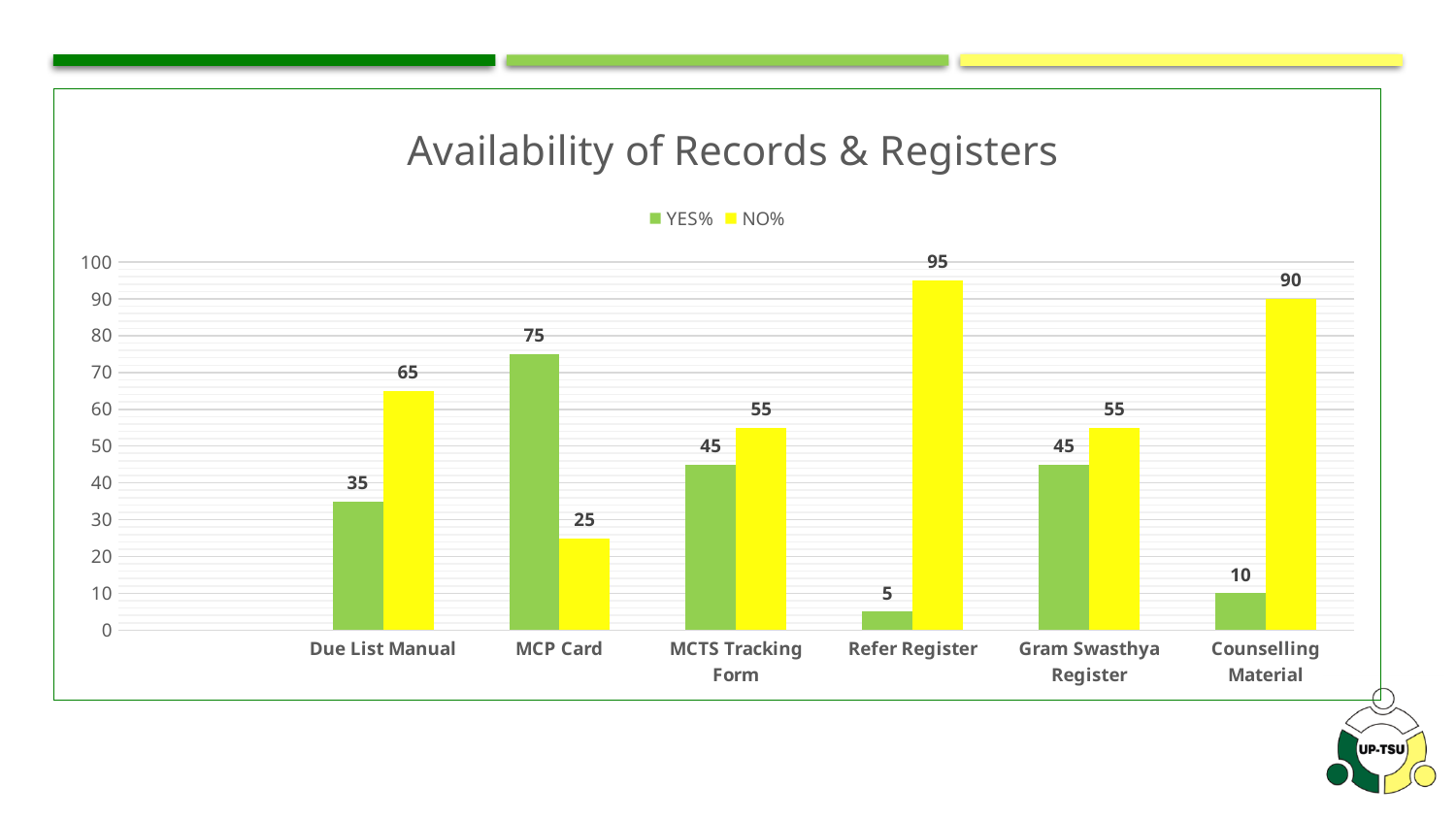
Which category has the highest NO% value? Refer Register What is the YES% value for Gram Swasthya Register? 45 What kind of chart is shown on the slide? Bar chart What is the YES% value for MCP Card? 75 Which is larger for MCP Card, YES% or NO%? YES% Which category has the lowest YES% value? Refer Register What is the NO% value for Refer Register? 95 How many series does the legend list? 2 What is the YES% value for Counselling Material? 10 What is the title of the chart? Availability of Records & Registers What is the difference between the NO% and YES% values for Due List Manual? 30 How many categories are shown on the x axis? 6